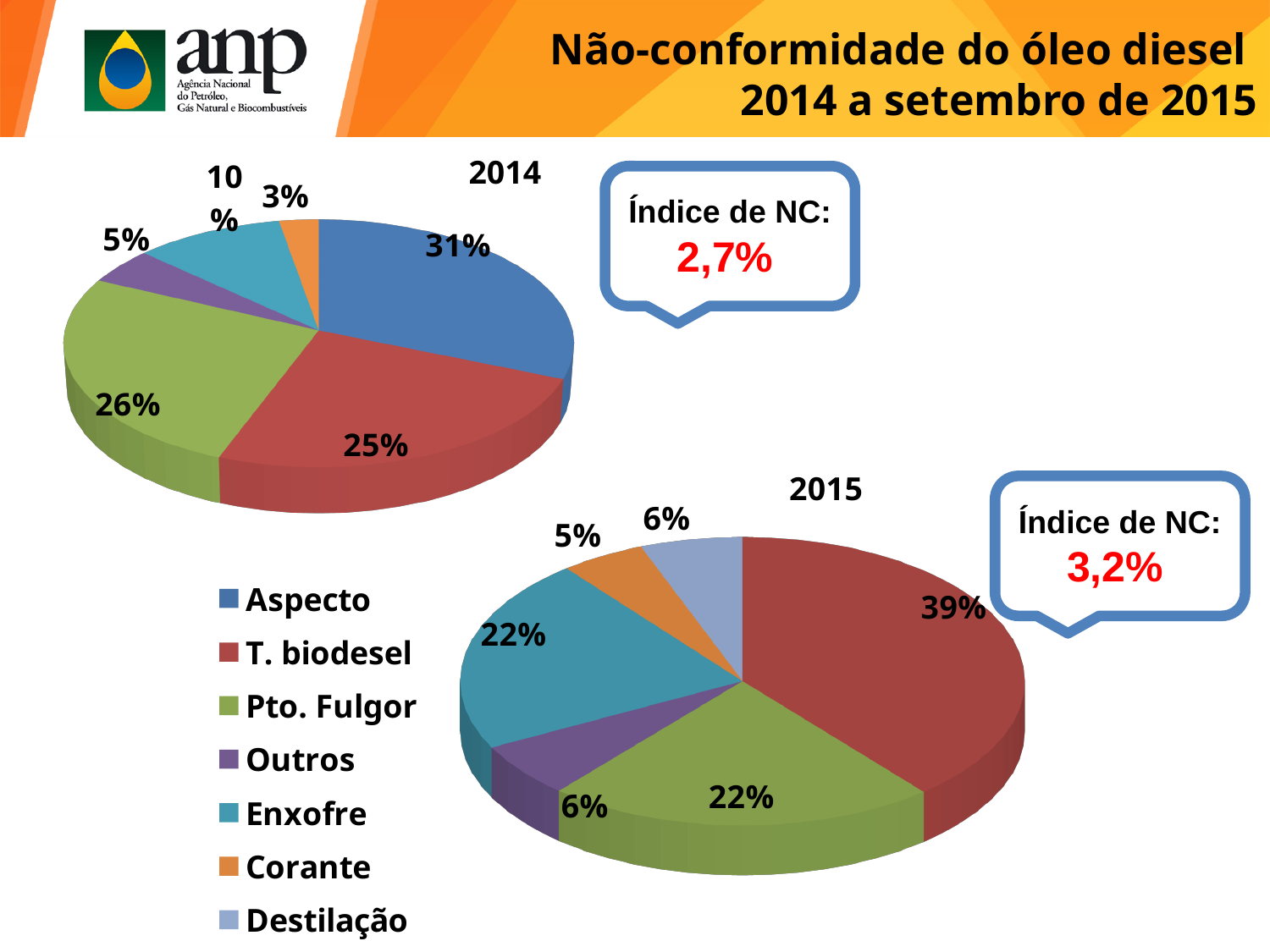
In the 2014 pie chart, what share does Pto. Fulgor have? 26% In the 2014 pie chart, which category has the smallest slice? Corante How many slices does the 2015 pie chart have? 6 In the 2015 pie chart, which category has the largest slice? T. biodesel In the 2014 pie chart, what share does Aspecto have? 31% In the 2015 pie chart, what share does Enxofre have? 22% In the 2015 pie chart, which category has the smallest slice? Corante In the 2015 pie chart, which is larger, the share for T. biodesel or the share for Pto. Fulgor? T. biodesel In the 2014 pie chart, what is the difference between the Aspecto share and the T. biodesel share? 6% What type of chart is used for the 2014 data? Pie chart In the 2015 pie chart, what share does T. biodesel have? 39% In the 2014 pie chart, which category has the largest slice? Aspecto